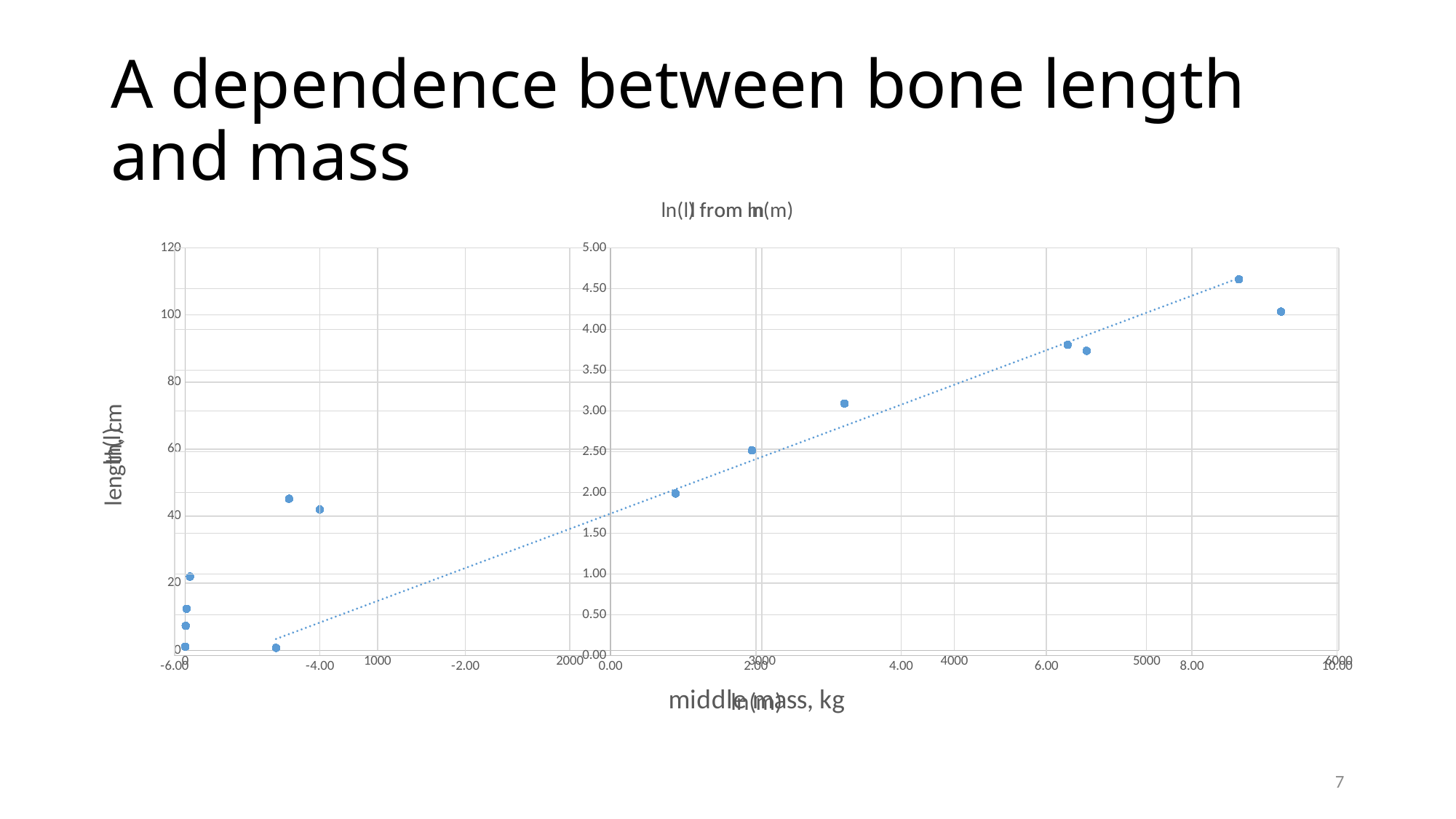
In the 'ln(l) from ln(m)' chart, do the ln(l) values generally rise or fall as ln(m) increases? rise In the 'ln(l) from ln(m)' chart, is the ln(l) value of the point near ln(m) = 6.3 greater or less than 3.50? greater In the 'ln(l) from ln(m)' chart, is the ln(l) value of the leftmost point (near ln(m) = -4.6) greater or less than 0.50? less What is the title of the chart with the dotted trend line? ln(l) from ln(m) What kind of chart is the 'ln(l) from ln(m)' chart? scatter chart In the 'ln(l) from ln(m)' chart, is the ln(m) value of the rightmost point greater or less than 8.00? greater What is the maximum value shown on the vertical axis of the 'ln(l) from ln(m)' chart? 5.00 In the 'ln(l) from ln(m)' chart, which point has the larger ln(l) value: the one near ln(m) = 2.0 or the one near ln(m) = 3.2? the one near ln(m) = 3.2